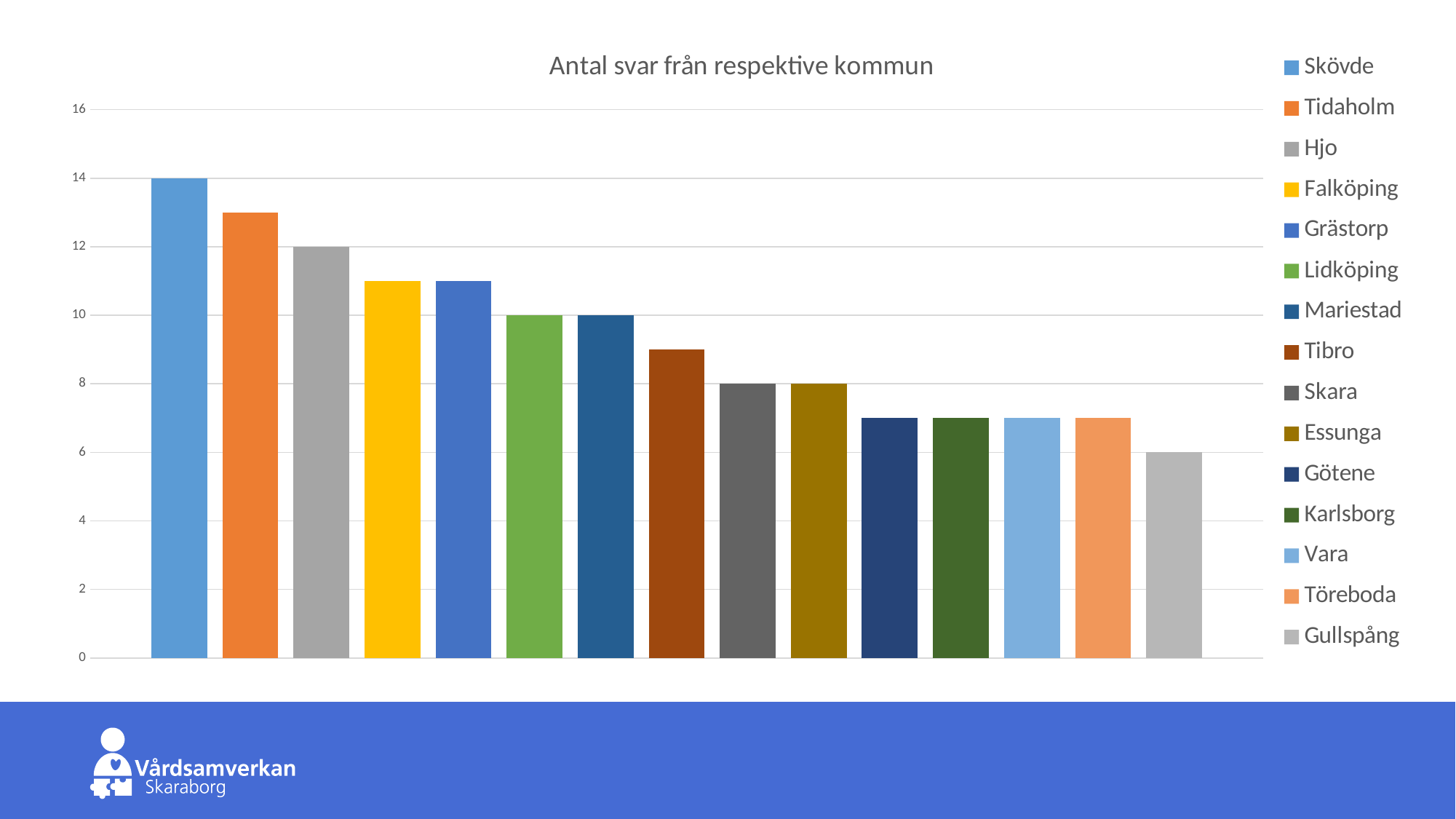
How many bars are plotted in the chart? 15 What kind of chart is shown on the slide? bar chart Is the value for Tidaholm greater or less than 12? greater How many entries does the legend list? 15 Which municipality has the highest number of responses? Skövde What is the title of the chart? Antal svar från respektive kommun What is the value for Skövde? 14 Is the value for Götene greater or less than 8? less Which municipality has the lowest number of responses? Gullspång What is the value for Hjo? 12 What is the difference between the values for Skövde and Gullspång? 8 What is the value for Gullspång? 6